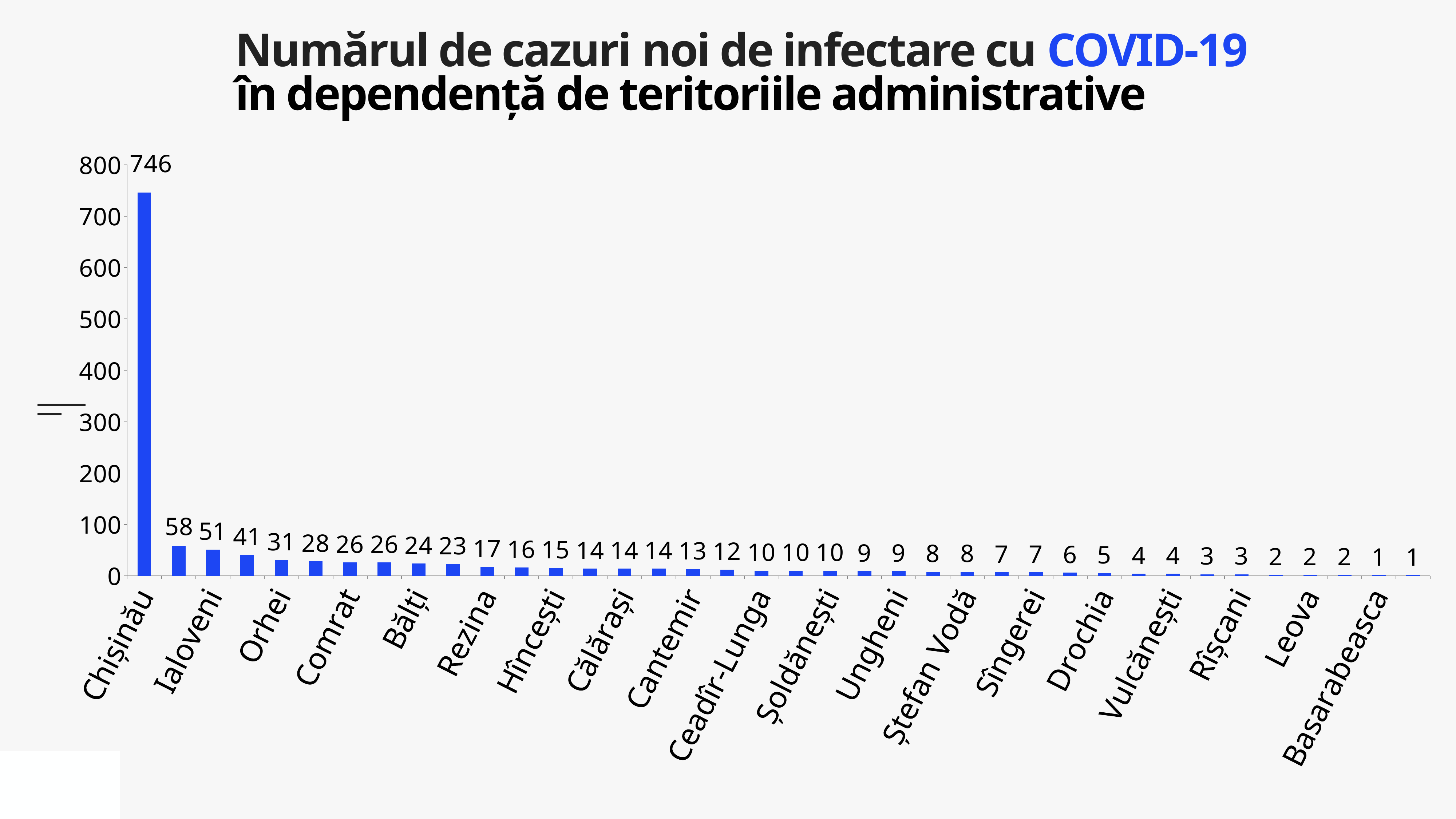
What is the value for Leova? 2 Do the values rise or fall from left to right along the x axis? fall What is the title of the chart? Numărul de cazuri noi de infectare cu COVID-19 în dependență de teritoriile administrative Which territory has the highest number of new cases? Chișinău What type of chart is shown on the slide? bar chart Which has a larger value, Chișinău or Ialoveni? Chișinău What is the highest value shown on the chart? 746 What is the lowest value shown on the chart? 1 What is the value for Basarabeasca? 1 Is the value for Chișinău greater or less than 700? greater What is the value for Chișinău? 746 What is the difference between the values for Chișinău and Basarabeasca? 745